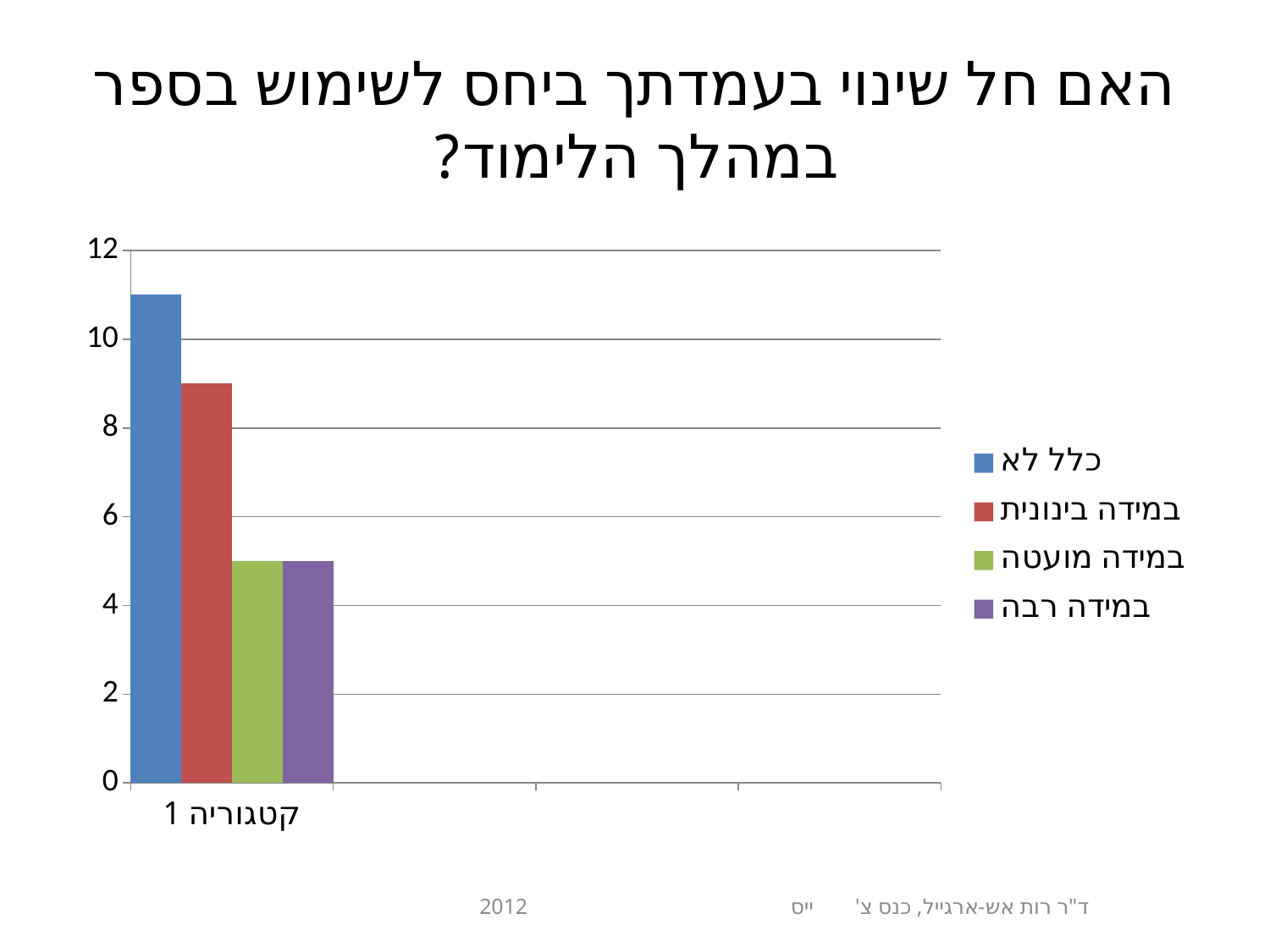
Which is larger, the value for במידה בינונית or the value for במידה מועטה? במידה בינונית What kind of chart is shown on the slide? bar chart How many categories are shown on the x axis? 1 Is the value for במידה בינונית greater or less than 8? greater What is the label of the category on the x axis? קטגוריה 1 Which series has the highest bar? כלל לא Is the value for במידה מועטה greater or less than 6? less Is the value for במידה בינונית greater or less than 10? less How many series does the legend list? 4 Which is larger, the value for כלל לא or the value for במידה בינונית? כלל לא